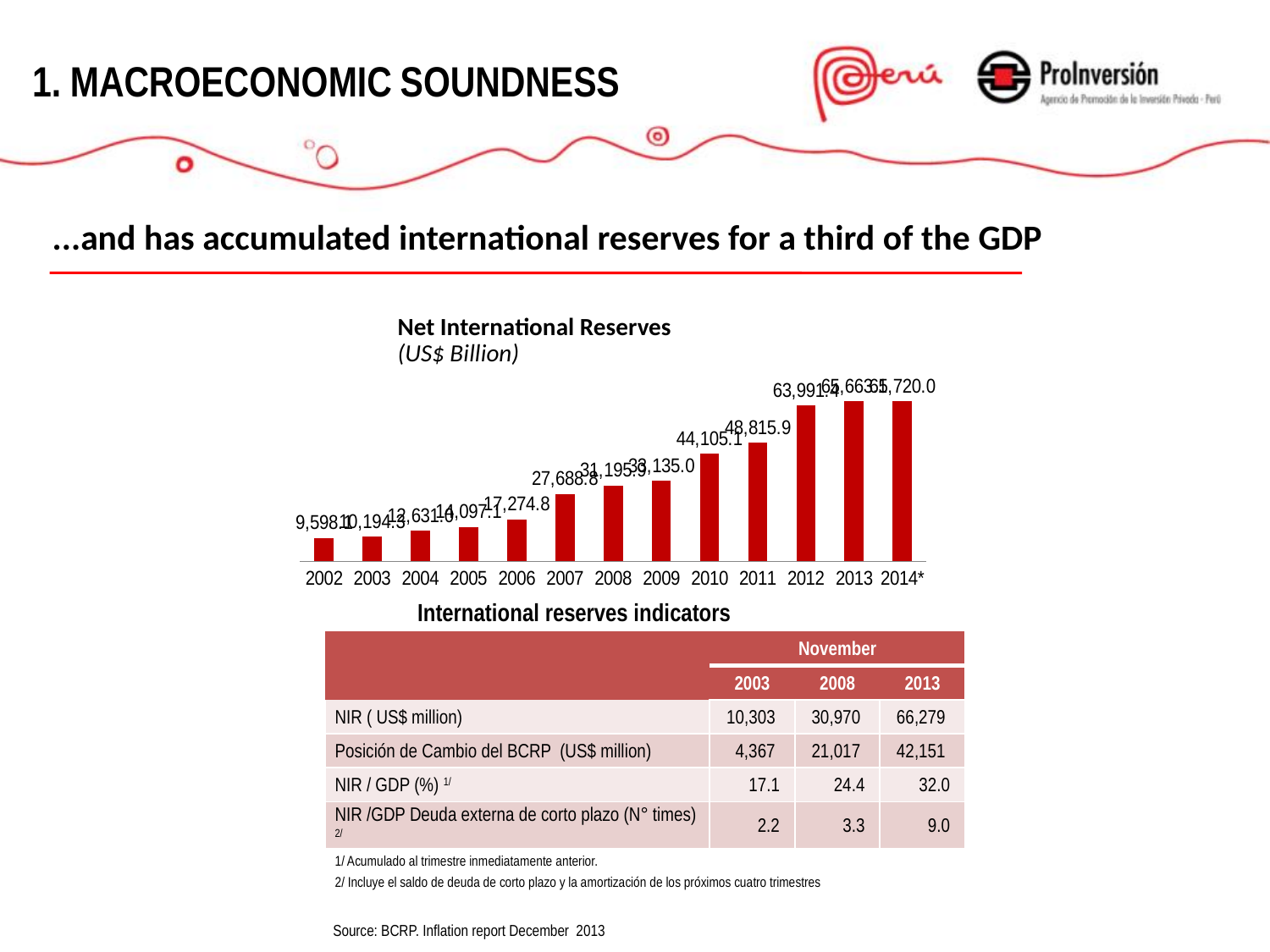
What is the value of Net International Reserves for 2002? 9,598.1 What is the value of Net International Reserves for 2010? 44,105.1 What is the difference in Net International Reserves between 2011 and 2010? 4,710.8 What unit is shown under the chart title? US$ Billion What is the value of Net International Reserves for 2014*? 65,720.0 What is the title of the chart on the slide? Net International Reserves What kind of chart is used to show Net International Reserves? bar chart Which year has higher Net International Reserves, 2009 or 2010? 2010 What is the value of Net International Reserves for 2011? 48,815.9 How many years are shown on the x axis of the Net International Reserves chart? 13 What is the value of Net International Reserves for 2006? 17,274.8 Which year has the lowest Net International Reserves? 2002